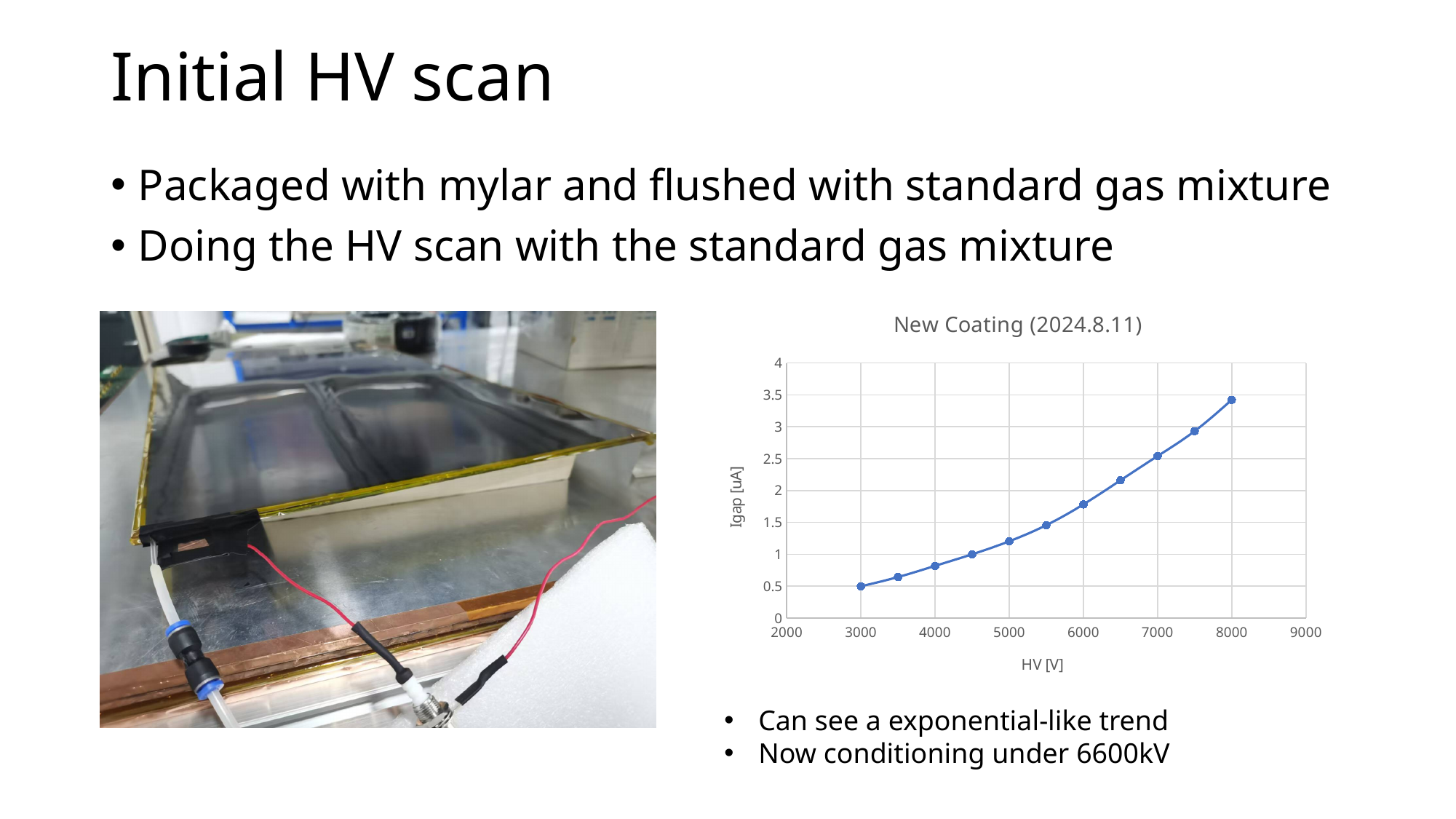
Which has the larger Igap value: HV = 7500 or HV = 5000? 7500 What is the title of the chart? New Coating (2024.8.11) What kind of chart is shown on the slide? line chart At which HV value is Igap lowest? 3000 Is the Igap value at HV = 6000 greater or less than 1.5? greater Is the Igap value at HV = 8000 greater or less than 3? greater Is the Igap value at HV = 3000 greater or less than 1? less At which HV value is Igap highest? 8000 How many data points are plotted in the chart? 11 What is the label of the y axis of the chart? Igap [uA] Does Igap rise or fall as HV increases along the x axis? rise